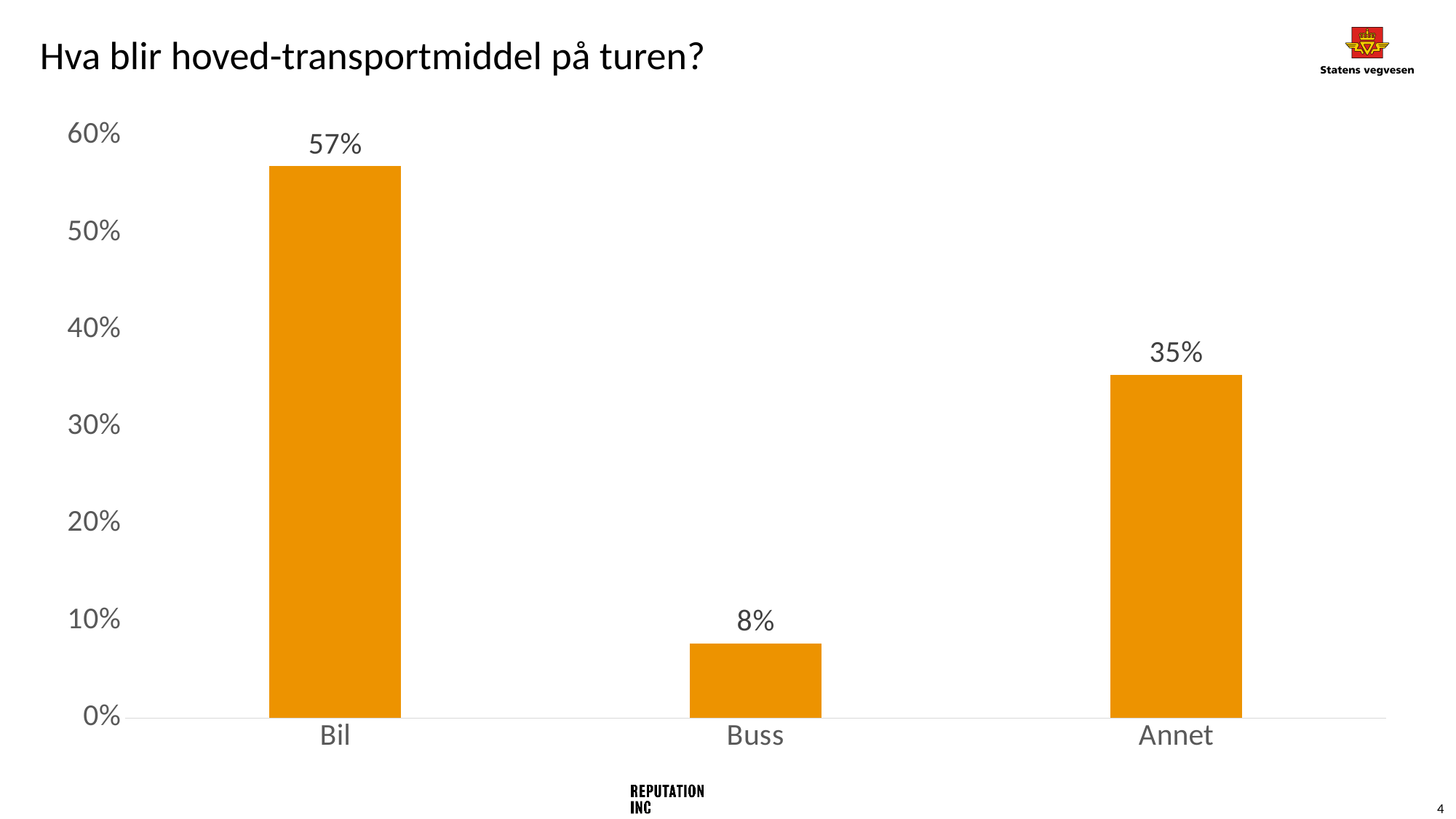
What is the difference between the values for Annet and Buss? 27% Which category has the highest value? Bil How many categories are shown on the x axis? 3 What kind of chart is shown on the slide? bar chart What is the value for Bil? 57% What is the title of the chart? Hva blir hoved-transportmiddel på turen? Is the value for Annet greater or less than 40%? less Which category has the lowest value? Buss What is the value for Annet? 35% What is the value for Buss? 8% Which is larger, the value for Buss or the value for Annet? Annet What is the difference between the values for Bil and Annet? 22%